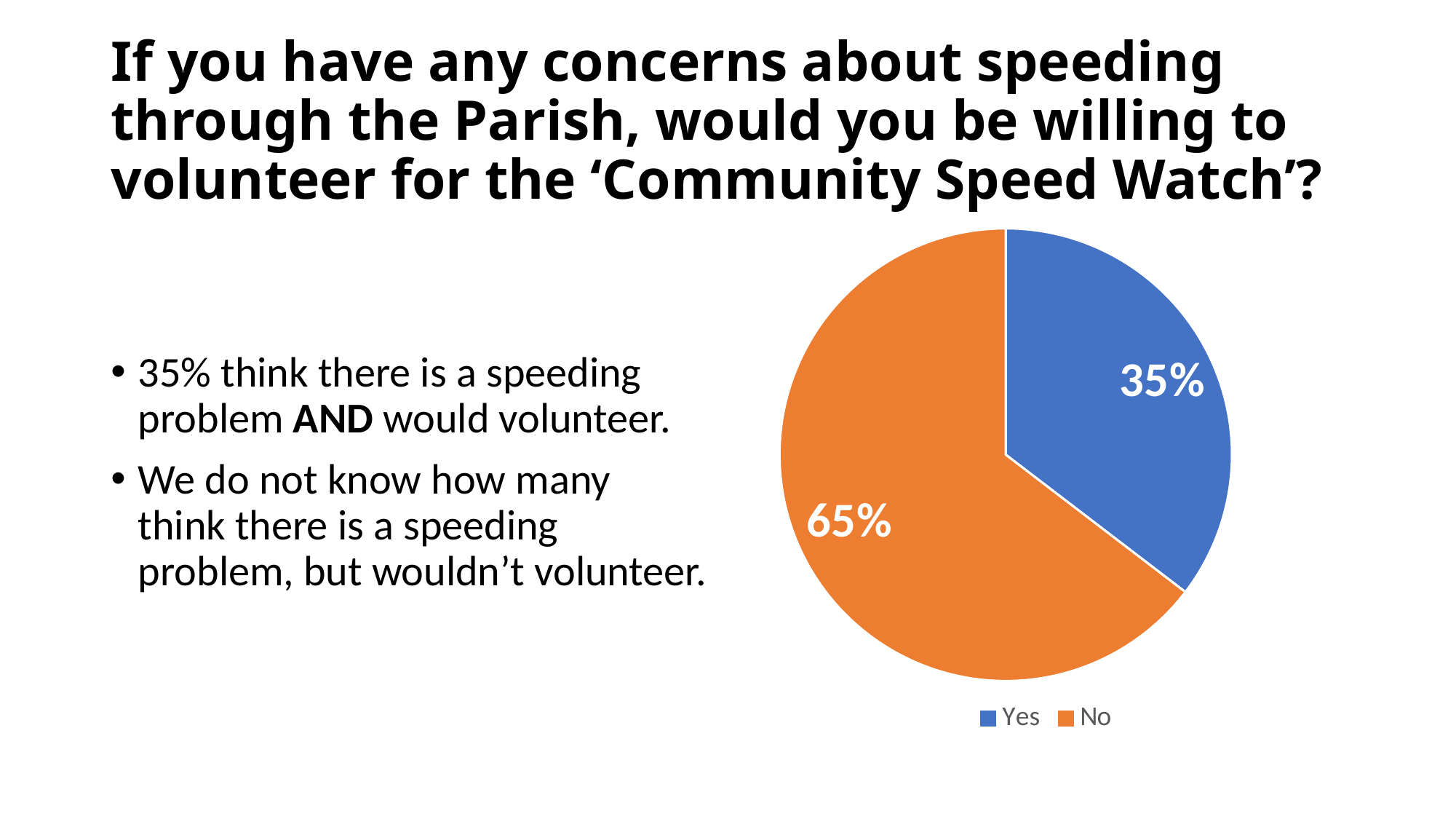
What is the difference in percentage points between the No and Yes slices? 30 How many entries does the legend list? 2 Which response has the largest share of the pie? No What colour is the No slice? orange What kind of chart is shown on the slide? pie chart What share of the pie does the Yes slice represent? 35% What percentage of respondents answered Yes? 35% What percentage of respondents answered No? 65% What colour is the Yes slice? blue How many slices does the pie chart have? 2 Which slice is larger, Yes or No? No Which response has the smallest share of the pie? Yes